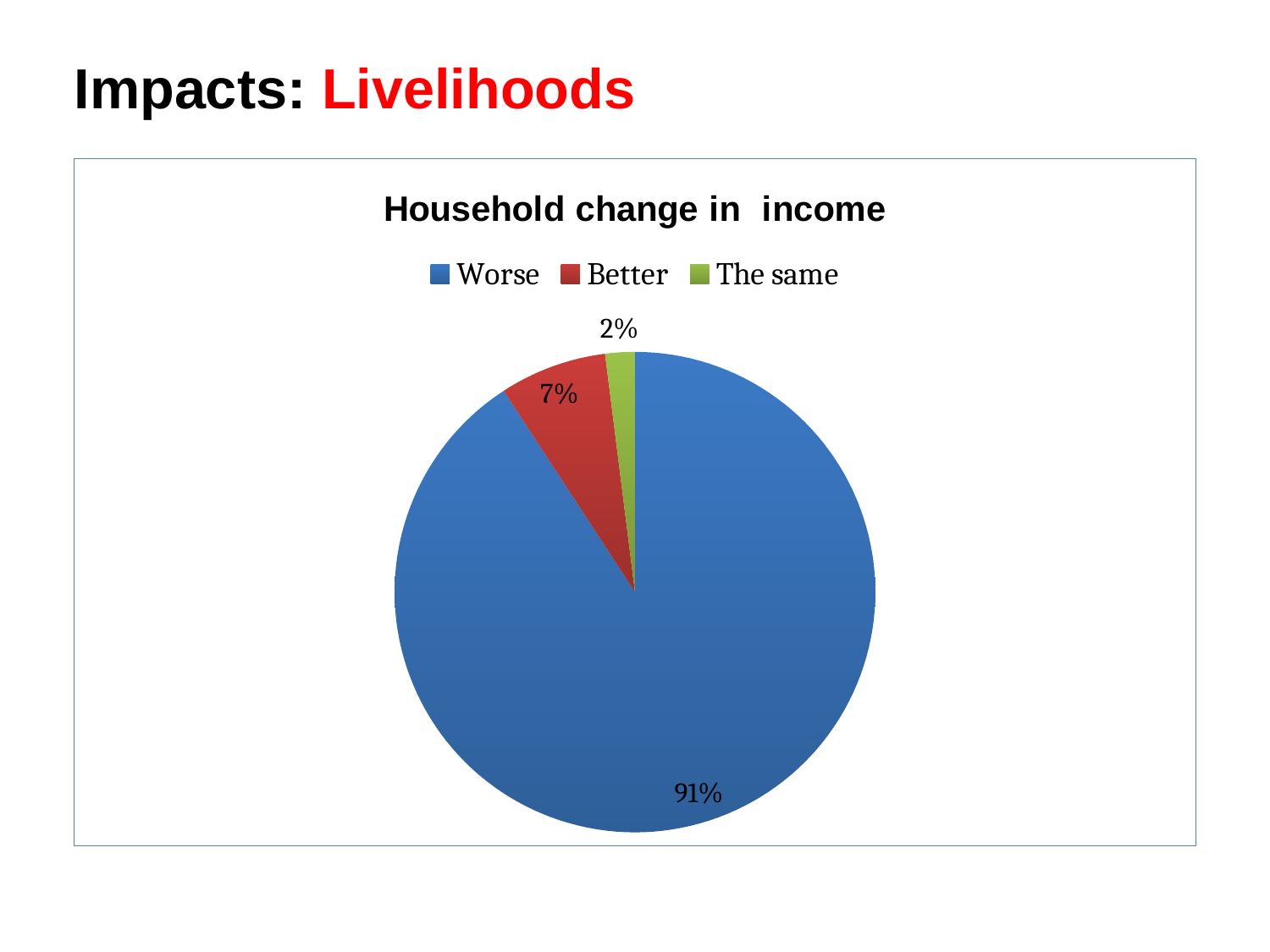
What percentage of households reported their income was Worse? 91% Which is larger, the Better slice or The same slice? Better How many entries does the legend list? 3 What is the difference in percentage points between the Worse and Better slices? 84 What percentage of households reported their income was The same? 2% What percentage of households reported their income was Better? 7% How many categories does the pie chart show? 3 What type of chart is shown on the slide? pie chart What colour is the Worse slice? blue Which category has the largest share of the pie? Worse What is the title of the chart? Household change in income Which category has the smallest share of the pie? The same